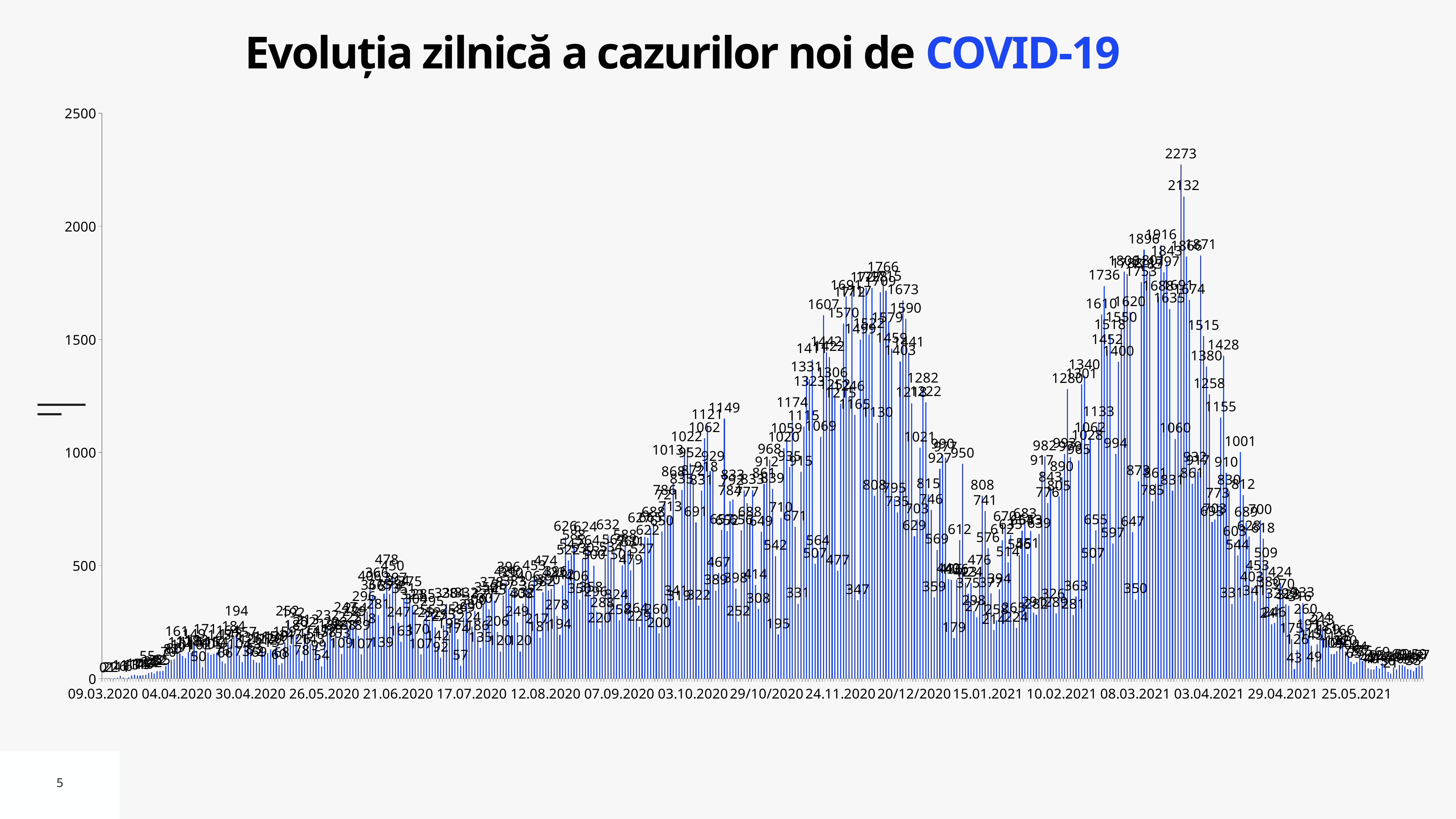
Which peak is higher: the one around 24.11.2020 or the one around 03.04.2021? The one around 03.04.2021 What is the maximum value shown on the y axis? 2500 What is the highest value labeled in the peak around 24.11.2020? 1766 Toward the right end of the x axis, after 25.05.2021, are the values rising or falling? Falling What is the second-highest value labeled on the chart, next to the 2273 peak? 2132 What is the title of the chart? Evoluția zilnică a cazurilor noi de COVID-19 What is the difference between the two highest labeled values, 2273 and 2132? 141 What kind of chart is shown on the slide? Bar chart Is the highest bar in the first wave, around 21.06.2020, greater or less than 500? less Is the highest bar on the chart greater or less than 2000? greater What is the highest daily value labeled on the chart? 2273 What is the first date label on the x axis? 09.03.2020